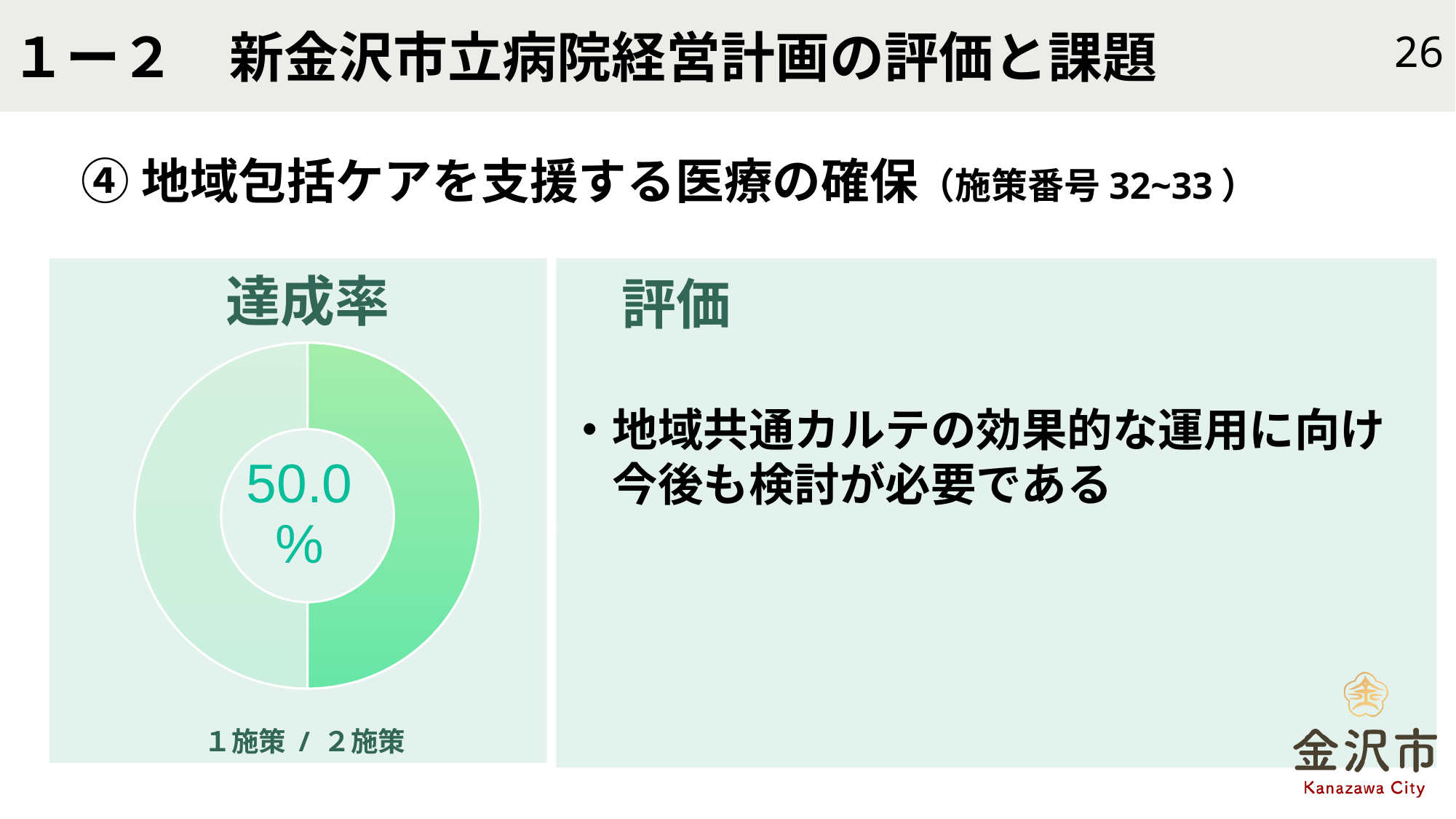
Is the achievement rate shown in the 達成率 donut chart greater or less than 25%? greater What share of the 達成率 donut does the darker green segment represent? 50.0% What value is printed in the centre of the 達成率 donut chart? 50.0% What text is printed below the 達成率 donut chart? 1施策 / 2施策 What is the title shown above the donut chart? 達成率 How many segments does the 達成率 donut chart have? 2 What kind of chart is shown under the heading 達成率? Donut (pie) chart Is the achievement rate shown in the 達成率 donut chart greater or less than 75%? less According to the label below the donut chart, how many 施策 were achieved out of the total? 1 out of 2